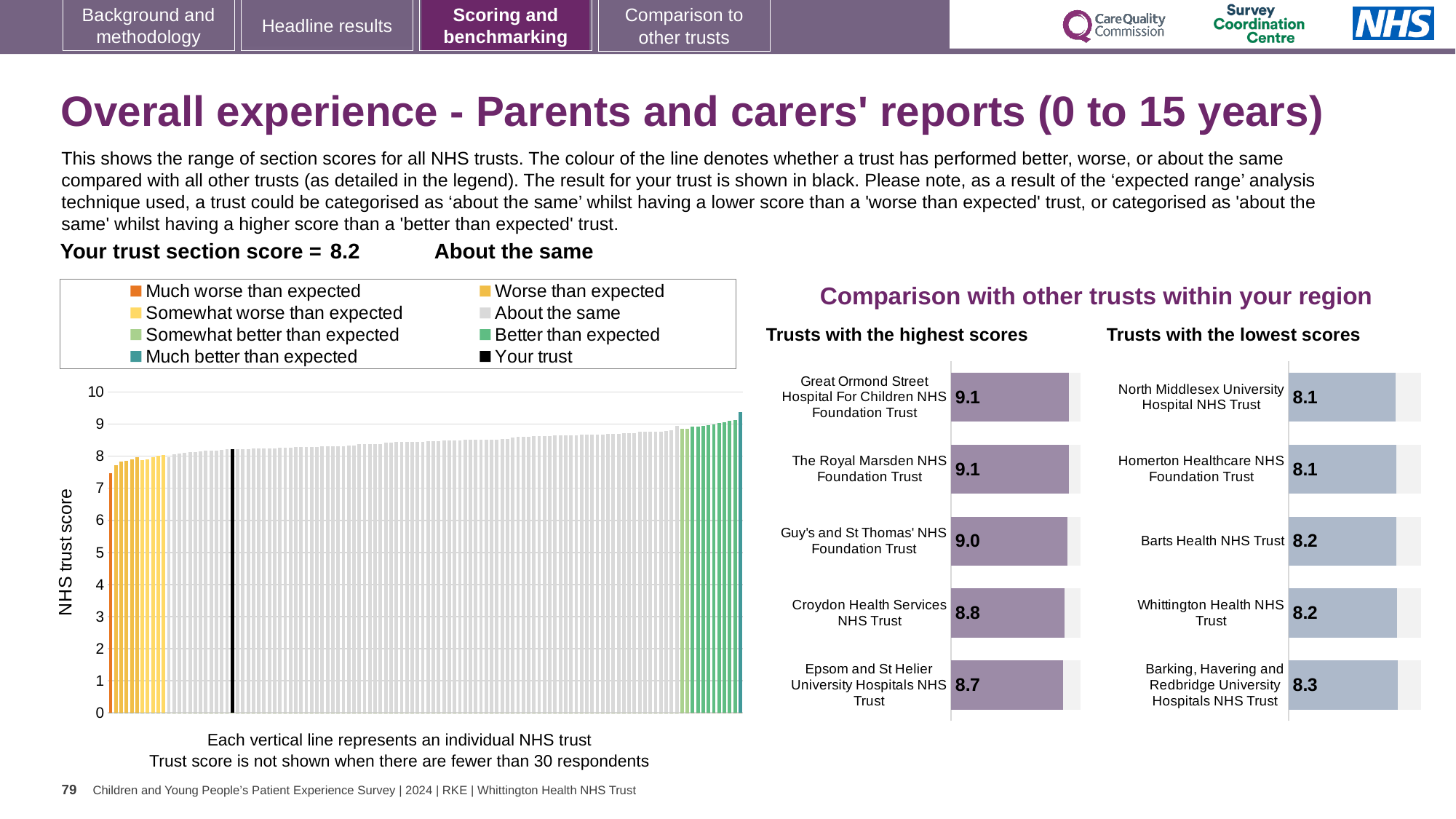
In the 'Trusts with the highest scores' chart, which trust has the lowest score? Epsom and St Helier University Hospitals NHS Trust How many trusts are shown in the 'Trusts with the lowest scores' chart? 5 In the NHS trust score chart on the left, do the values rise or fall from left to right? Rise In the 'Trusts with the lowest scores' chart, which trust has the highest score? Barking, Havering and Redbridge University Hospitals NHS Trust What kind of chart is the NHS trust score chart on the left of the slide? Bar chart In the 'Trusts with the highest scores' chart, what is the difference between the scores of Great Ormond Street Hospital For Children NHS Foundation Trust and Epsom and St Helier University Hospitals NHS Trust? 0.4 In the 'Trusts with the highest scores' chart, what is the score for Guy's and St Thomas' NHS Foundation Trust? 9.0 In the 'Trusts with the lowest scores' chart, which has the larger score: Barts Health NHS Trust or Barking, Havering and Redbridge University Hospitals NHS Trust? Barking, Havering and Redbridge University Hospitals NHS Trust In the 'Trusts with the highest scores' chart, what is the score for Croydon Health Services NHS Trust? 8.8 How many entries does the legend of the NHS trust score chart list? 8 In the NHS trust score chart on the left, is the value for the black 'Your trust' bar greater or less than 5? greater In the 'Trusts with the lowest scores' chart, what is the score for Barking, Havering and Redbridge University Hospitals NHS Trust? 8.3